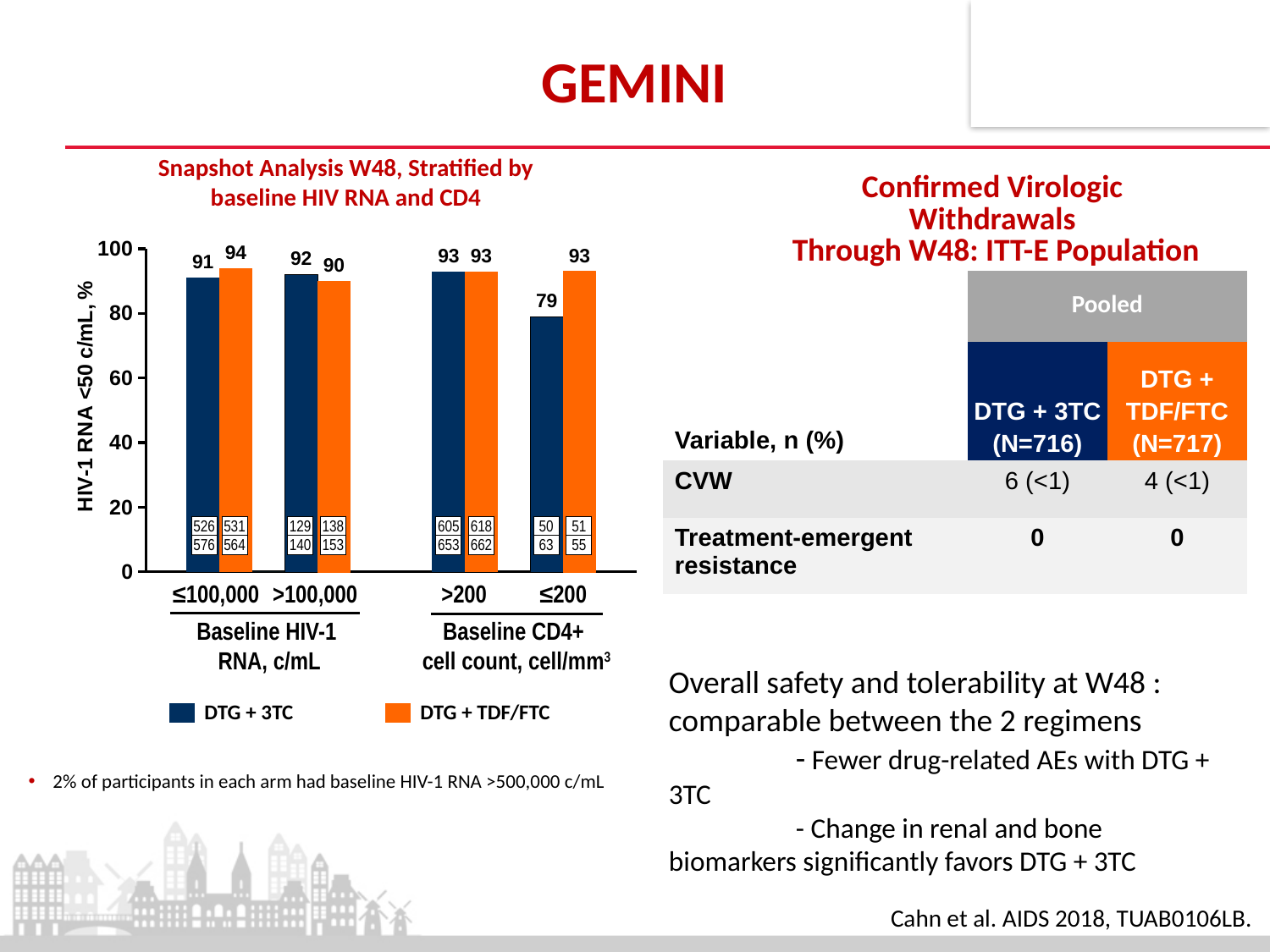
How many series does the chart legend list? 2 What is the label of the y axis of the chart? HIV-1 RNA <50 c/mL, % Which category has the lowest value for DTG + 3TC? ≤200 What is the value for DTG + TDF/FTC in the >100,000 baseline HIV-1 RNA category? 90 What is the difference between DTG + TDF/FTC and DTG + 3TC in the ≤200 baseline CD4+ category? 14 Is the value for DTG + 3TC in the ≤200 baseline CD4+ category greater or less than 80? less What kind of chart is shown on the slide? Bar chart What is the value for DTG + 3TC in the ≤100,000 baseline HIV-1 RNA category? 91 What is the value for DTG + TDF/FTC in the ≤100,000 baseline HIV-1 RNA category? 94 What is the value for DTG + 3TC in the ≤200 baseline CD4+ cell count category? 79 Which category has the highest value for DTG + TDF/FTC? ≤100,000 In the >100,000 baseline HIV-1 RNA category, which series has the larger value, DTG + 3TC or DTG + TDF/FTC? DTG + 3TC